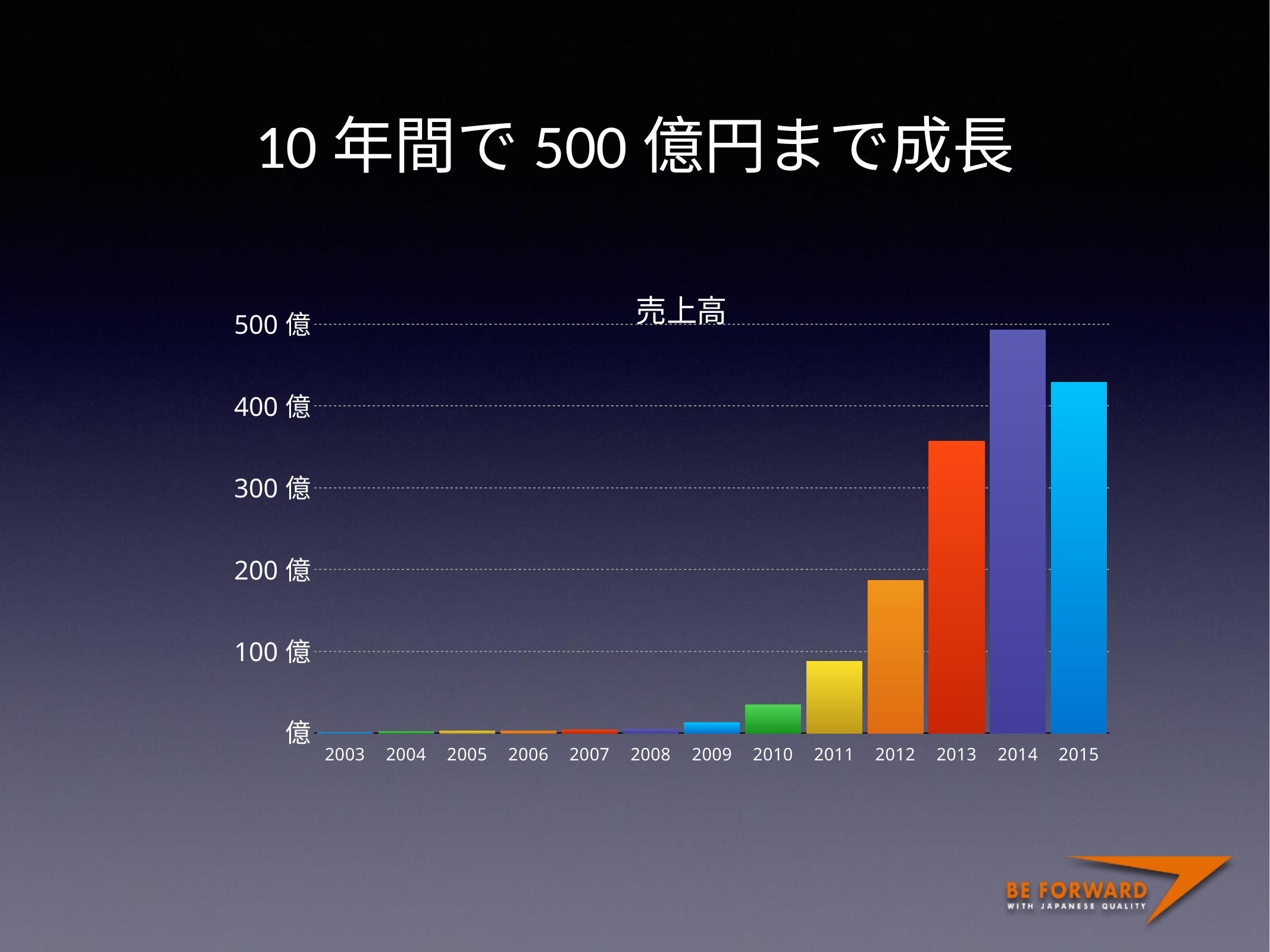
Which year has the highest bar in the chart? 2014 What is the title of the chart? 売上高 Is the value for 2012 greater or less than 200 億? less What kind of chart is shown on the slide? bar chart Do the values generally rise or fall from 2003 to 2014? rise How many years are shown on the x axis of the chart? 13 Which is larger, the value for 2012 or the value for 2013? 2013 Is the value for 2015 greater or less than 500 億? less Is the value for 2015 greater or less than 400 億? greater Which is larger, the value for 2014 or the value for 2015? 2014